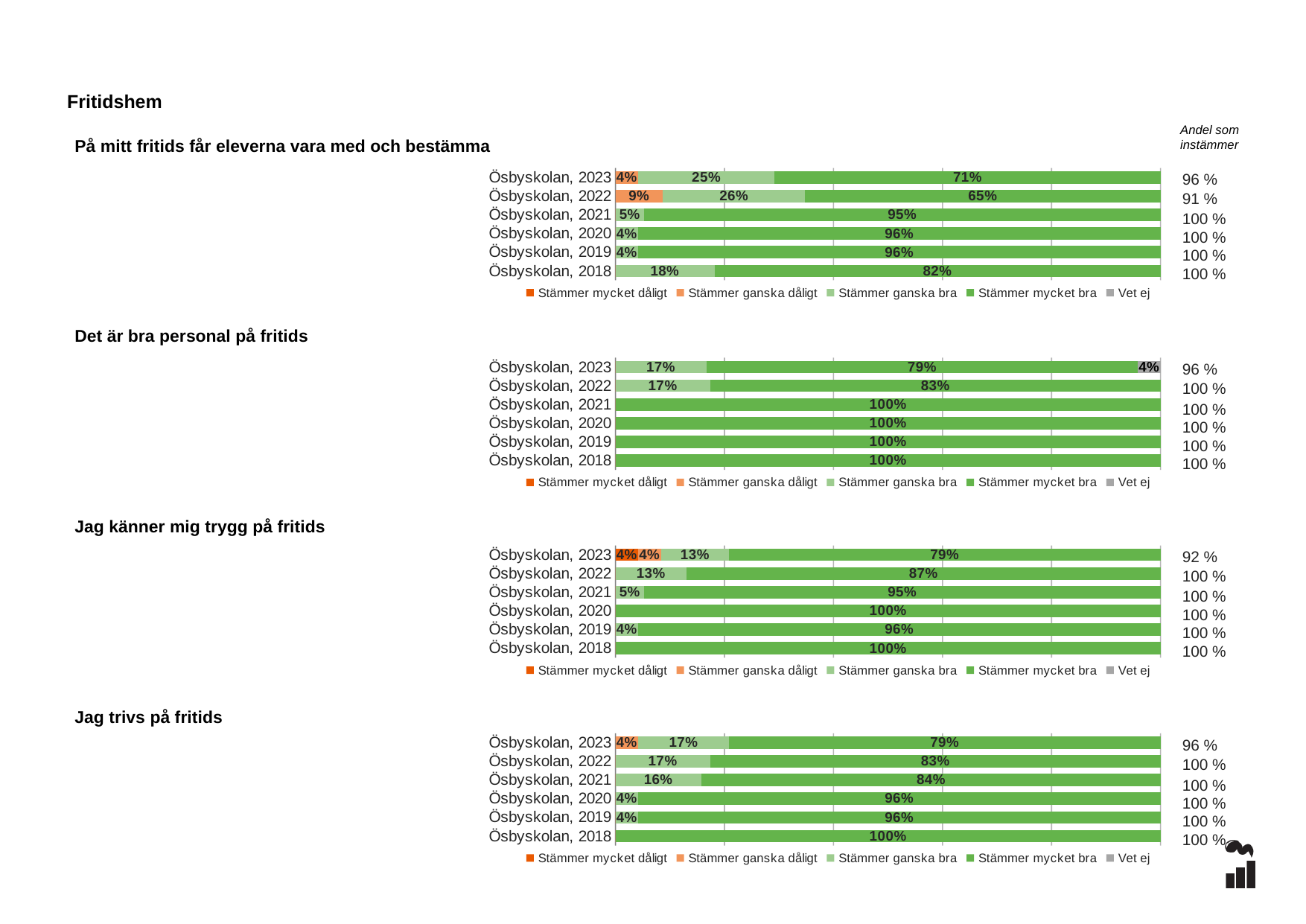
In the chart 'Jag trivs på fritids', what is the value of 'Stämmer ganska bra' for Ösbyskolan, 2021? 16% In the chart 'På mitt fritids får eleverna vara med och bestämma', how many percentage points higher is 'Stämmer mycket bra' for Ösbyskolan, 2023 than for Ösbyskolan, 2022? 6 percentage points In the chart 'På mitt fritids får eleverna vara med och bestämma', what is the value of 'Stämmer mycket bra' for Ösbyskolan, 2022? 65% How many categories (rows) are shown in the chart 'Jag känner mig trygg på fritids'? 6 In the chart 'På mitt fritids får eleverna vara med och bestämma', what is the value of 'Stämmer ganska bra' for Ösbyskolan, 2018? 18% What kind of chart is 'Jag trivs på fritids'? Stacked bar chart In the chart 'Det är bra personal på fritids', what is the value of 'Vet ej' for Ösbyskolan, 2023? 4% In the chart 'Jag trivs på fritids', which is larger for 'Stämmer mycket bra': Ösbyskolan, 2021 or Ösbyskolan, 2020? Ösbyskolan, 2020 In the chart 'Jag känner mig trygg på fritids', what is the value of 'Stämmer mycket bra' for Ösbyskolan, 2022? 87% How many series does the legend of the chart 'Det är bra personal på fritids' list? 5 In the chart 'På mitt fritids får eleverna vara med och bestämma', what is the 'Andel som instämmer' shown for Ösbyskolan, 2022? 91 % In the chart 'Jag känner mig trygg på fritids', which category has the lowest value for 'Stämmer mycket bra'? Ösbyskolan, 2023